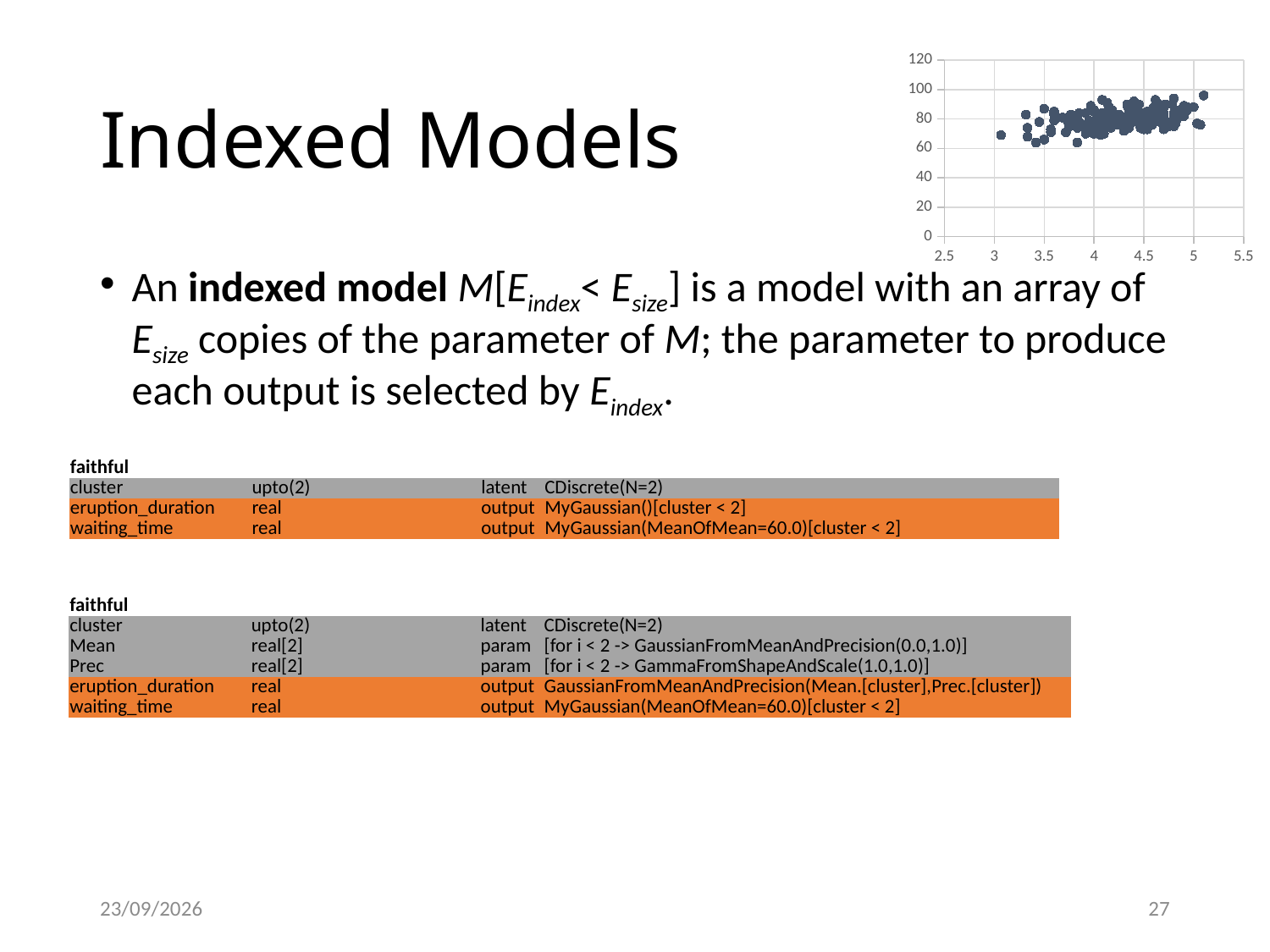
What is the highest tick value shown on the y axis of the scatter chart? 120 In the scatter chart, are the plotted points greater or less than 100 on the y axis? less What is the lowest tick value shown on the x axis of the scatter chart? 2.5 In the scatter chart, are the plotted points greater or less than 40 on the y axis? greater In the scatter chart, do the y values generally rise or fall as x increases? rise What kind of chart is shown in the top right of the slide? scatter chart In the scatter chart, are the plotted points greater or less than 5.5 on the x axis? less